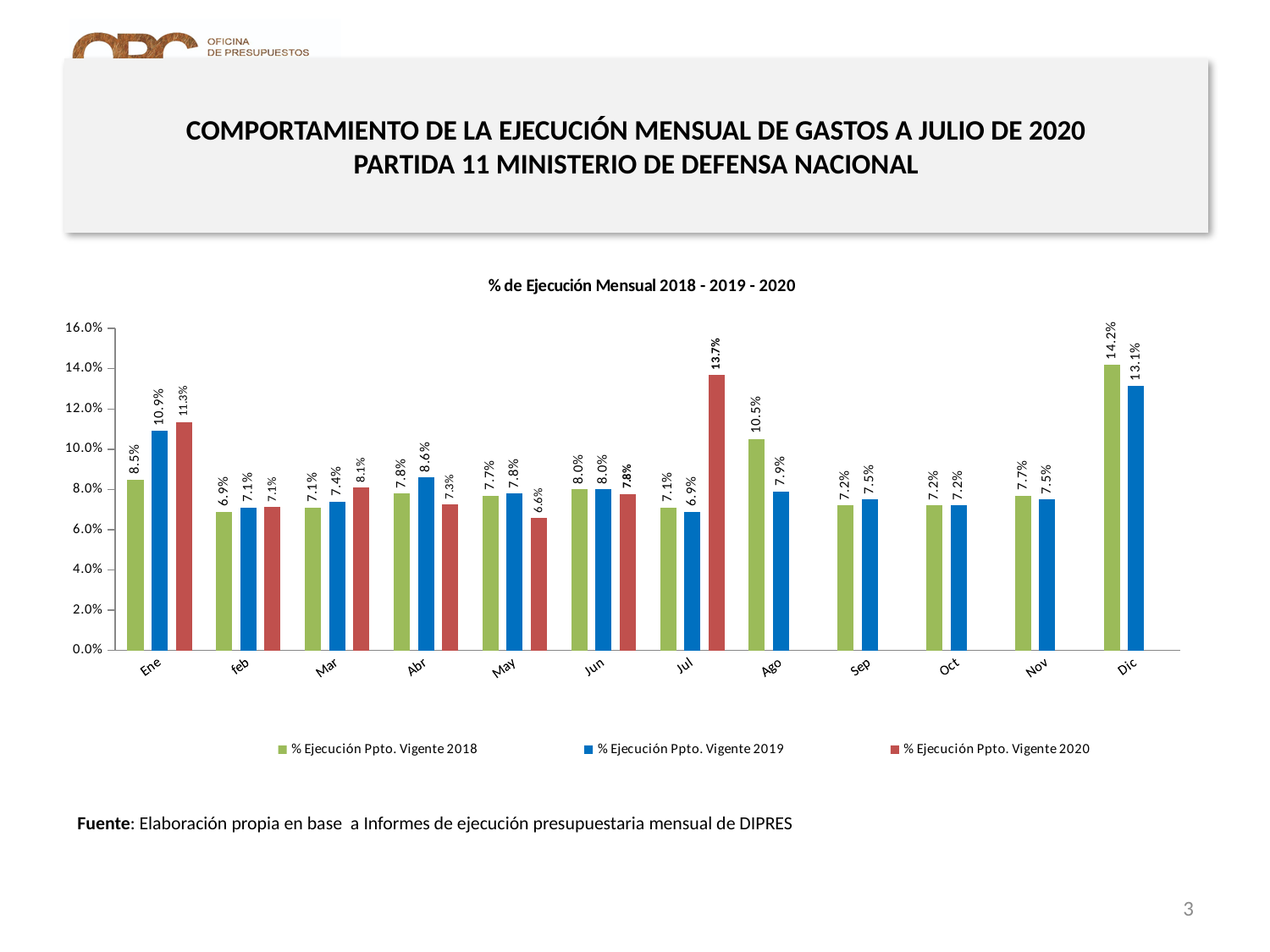
In which month does the % Ejecución Ppto. Vigente 2020 series have its lowest value? May In which month does the % Ejecución Ppto. Vigente 2020 series reach its highest value? Jul What kind of chart is shown on the slide? Bar chart Is the value of % Ejecución Ppto. Vigente 2018 for Ago greater or less than 10.0%? greater What is the value of % Ejecución Ppto. Vigente 2019 for Ene? 10.9% Which is larger for Abr: the 2019 value or the 2020 value? 2019 (8.6%) How many months are shown on the x axis? 12 What is the difference between the 2020 and 2019 values for Jul? 6.8 percentage points What is the value of % Ejecución Ppto. Vigente 2020 for Jul? 13.7% How many series does the legend list? 3 What is the title of the chart? % de Ejecución Mensual 2018 - 2019 - 2020 What is the value of % Ejecución Ppto. Vigente 2018 for Dic? 14.2%